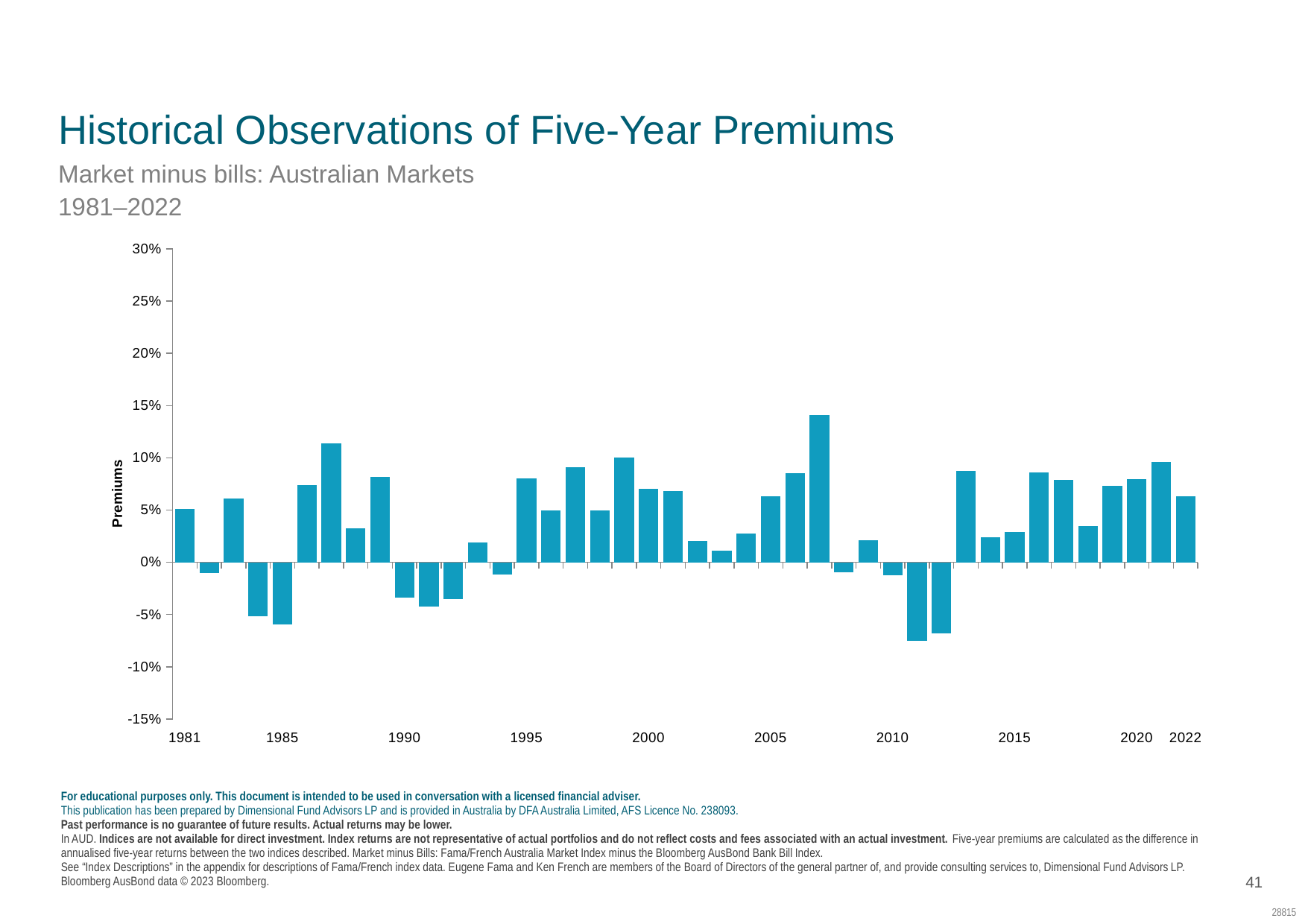
Is the value for 1985 greater or less than -5%? less How many years (bars) are plotted in the chart? 42 Is the value for 1990 greater or less than 0%? less Which is larger, the value for 2007 or the value for 1987? 2007 Is the value for 2011 greater or less than -5%? less Which is larger, the value for 2021 or the value for 2022? 2021 What kind of chart is shown on the slide? Bar chart Which year has the highest five-year premium in the chart? 2007 What is the label on the vertical axis of the chart? Premiums